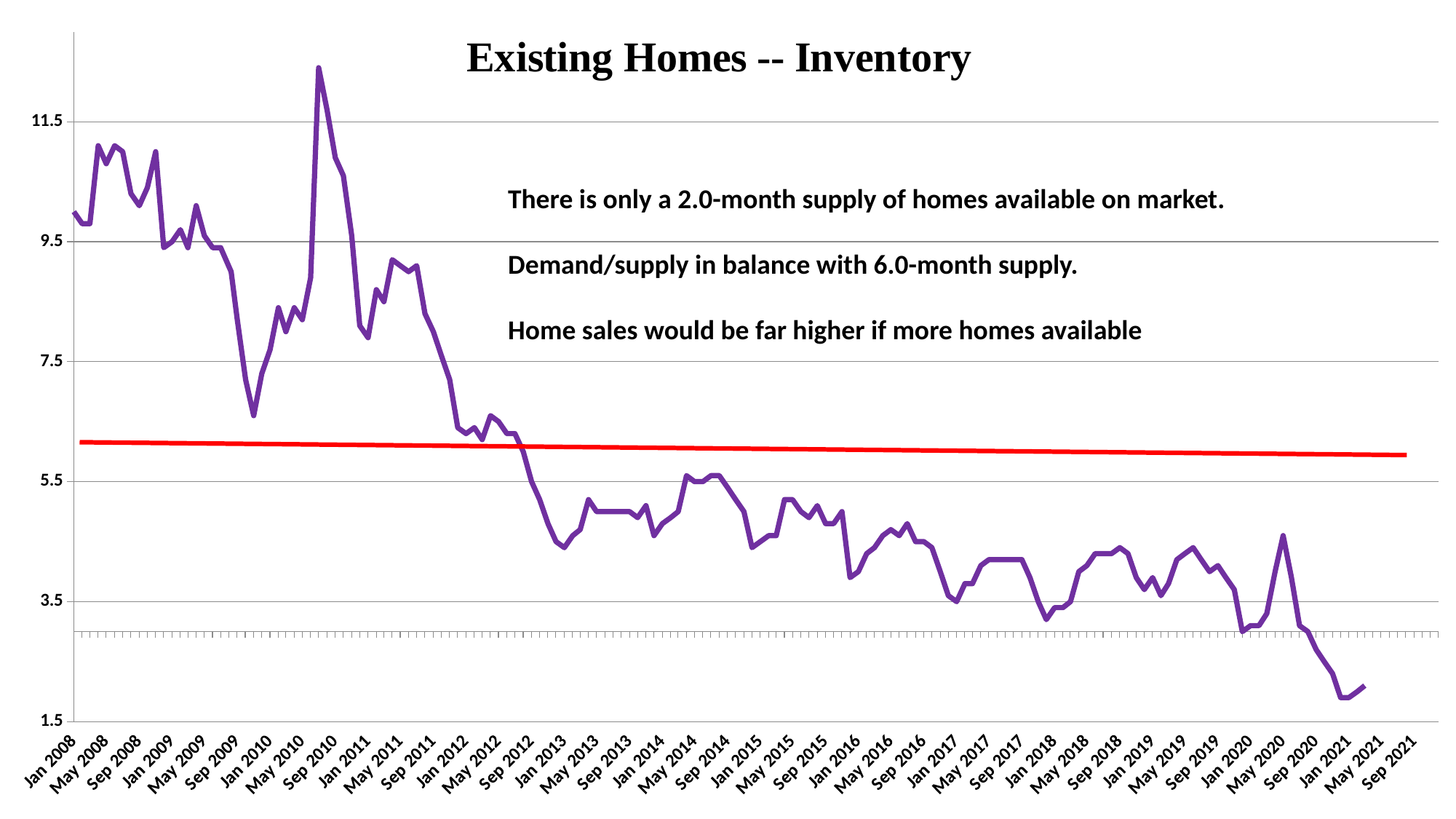
Which is larger, the value for Jan 2010 or the value for Sep 2010? Sep 2010 Which is larger, the value for Jan 2008 or the value for Jan 2021? Jan 2008 Is the value at the peak near Sep 2010 greater or less than 11.5? greater What colour is the nearly flat trend line drawn across the chart? Red Is the value for Jan 2013 greater or less than 5.5? less Overall, does the purple inventory line rise or fall from Jan 2008 to 2021? Fall What is the title of the chart? Existing Homes -- Inventory Around which month does the purple line reach its lowest value? Jan 2021 What type of chart is shown on the slide? Line chart Is the value for Jan 2021 greater or less than 3.5? less